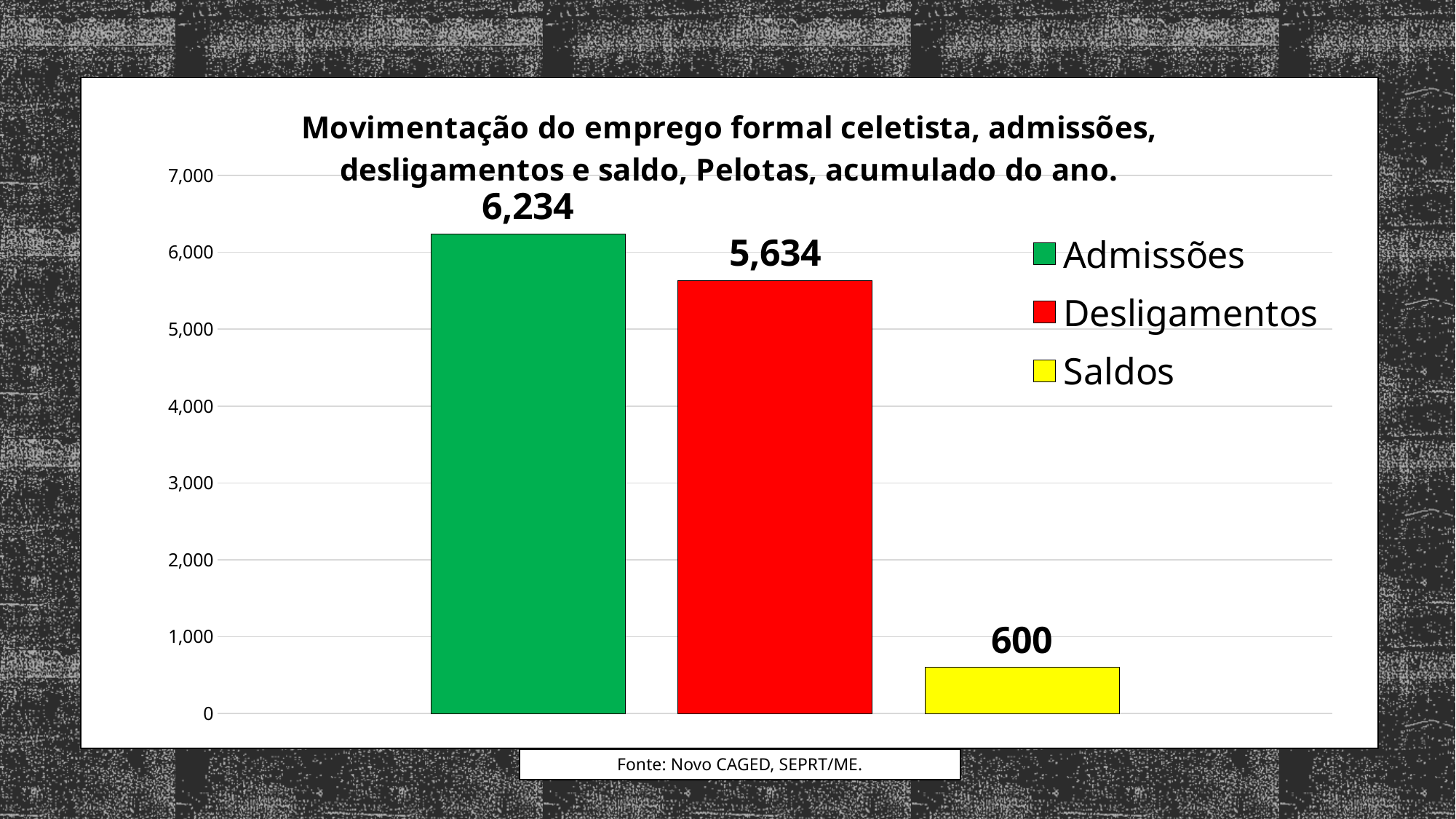
Which is larger, Desligamentos or Saldos? Desligamentos What is the value for Admissões? 6,234 Which series has the lowest value? Saldos What colour is the bar for Saldos? yellow How many series does the legend list? 3 What is the value for Desligamentos? 5,634 How many bars are plotted on the chart? 3 Is the value for Desligamentos greater or less than 5,000? greater What kind of chart is shown on the slide? bar chart What is the value for Saldos? 600 Which series has the highest value? Admissões What is the difference between Admissões and Desligamentos? 600